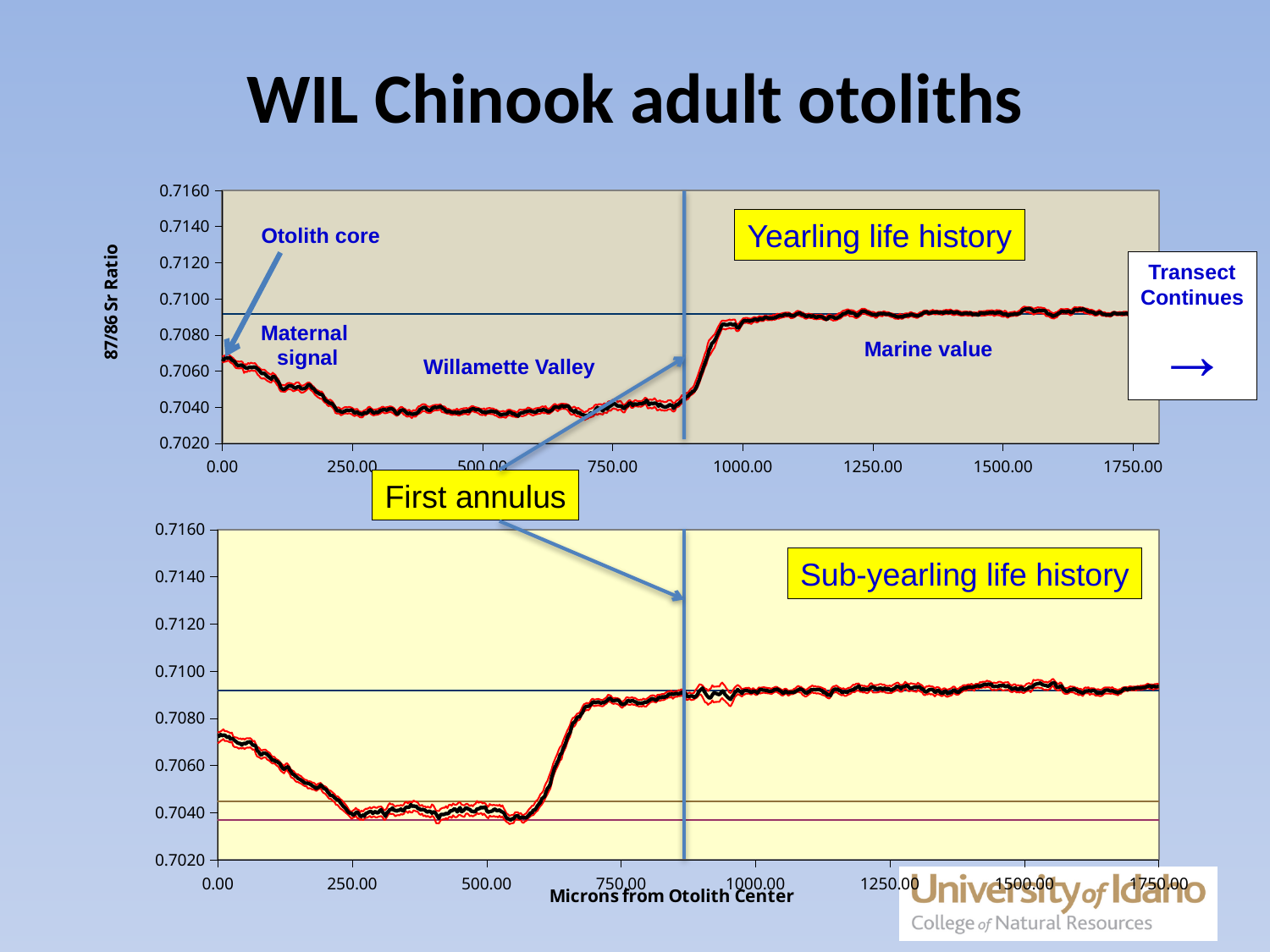
In the bottom chart (Sub-yearling life history), is the value at 1000.00 microns greater or less than 0.7080? greater In the top chart (Yearling life history), is the value at 1500.00 microns greater or less than 0.7080? greater In the bottom chart (Sub-yearling life history), which is larger: the value at 250.00 microns or the value at 750.00 microns? 750.00 microns In the top chart (Yearling life history), is the value at 250.00 microns greater or less than 0.7060? less In the top chart (Yearling life history), does the Sr ratio rise or fall between 750.00 and 1000.00 microns? rise What is the x-axis label shown beneath the bottom chart? Microns from Otolith Center What kind of chart is the top chart on the slide? line chart In the top chart (Yearling life history), does the Sr ratio rise or fall between 0.00 and 250.00 microns? fall In the top chart (Yearling life history), which is larger: the value at 500.00 microns or the value at 1500.00 microns? 1500.00 microns What is the title of the slide? WIL Chinook adult otoliths